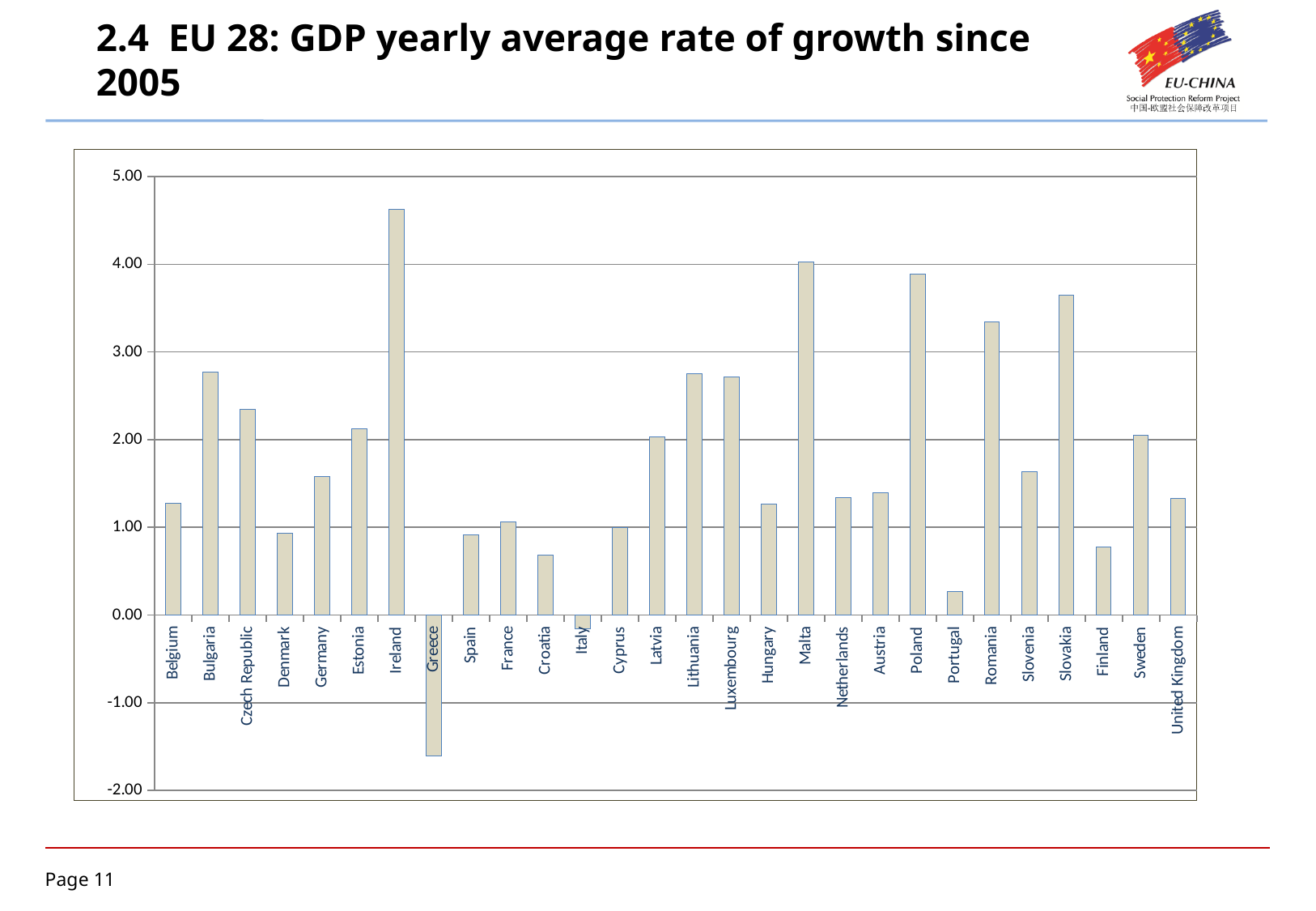
Which country has the lowest GDP yearly average rate of growth in the chart? Greece What kind of chart is shown on the slide? bar chart How many countries have a negative GDP yearly average rate of growth in the chart? 2 Which has the higher value, Ireland or Malta? Ireland Is the value for Ireland greater or less than 4.00? greater Which country has the highest GDP yearly average rate of growth in the chart? Ireland How many countries are shown in the chart? 28 Is the value for Greece greater or less than -1.00? less What is the title of the slide containing the chart? 2.4 EU 28: GDP yearly average rate of growth since 2005 Is the value for Portugal greater or less than 1.00? less Which has the higher value, Bulgaria or Czech Republic? Bulgaria